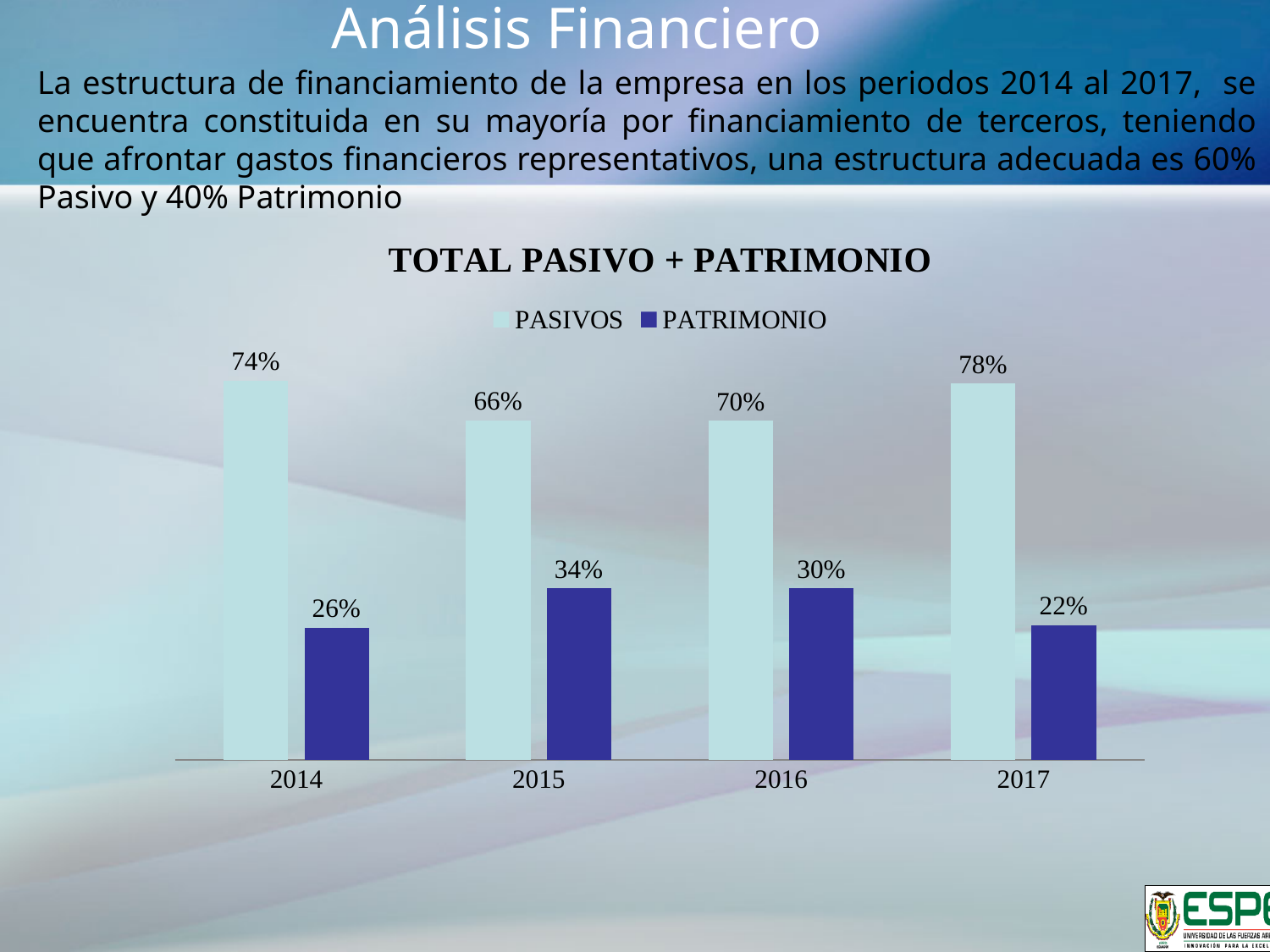
What is the title of the chart? TOTAL PASIVO + PATRIMONIO What kind of chart is shown on the slide? Bar chart How many series does the legend list? 2 In which year is the PATRIMONIO value lowest? 2017 What is the PATRIMONIO value for 2015? 34% How many years are shown on the x axis? 4 What is the difference between the PASIVOS and PATRIMONIO values in 2016? 40% Which is larger in 2015, the PASIVOS value or the PATRIMONIO value? PASIVOS In which year is the PASIVOS value highest? 2017 What is the PASIVOS value for 2014? 74% Does the PATRIMONIO value rise or fall from 2015 to 2017? Fall What is the PATRIMONIO value for 2017? 22%